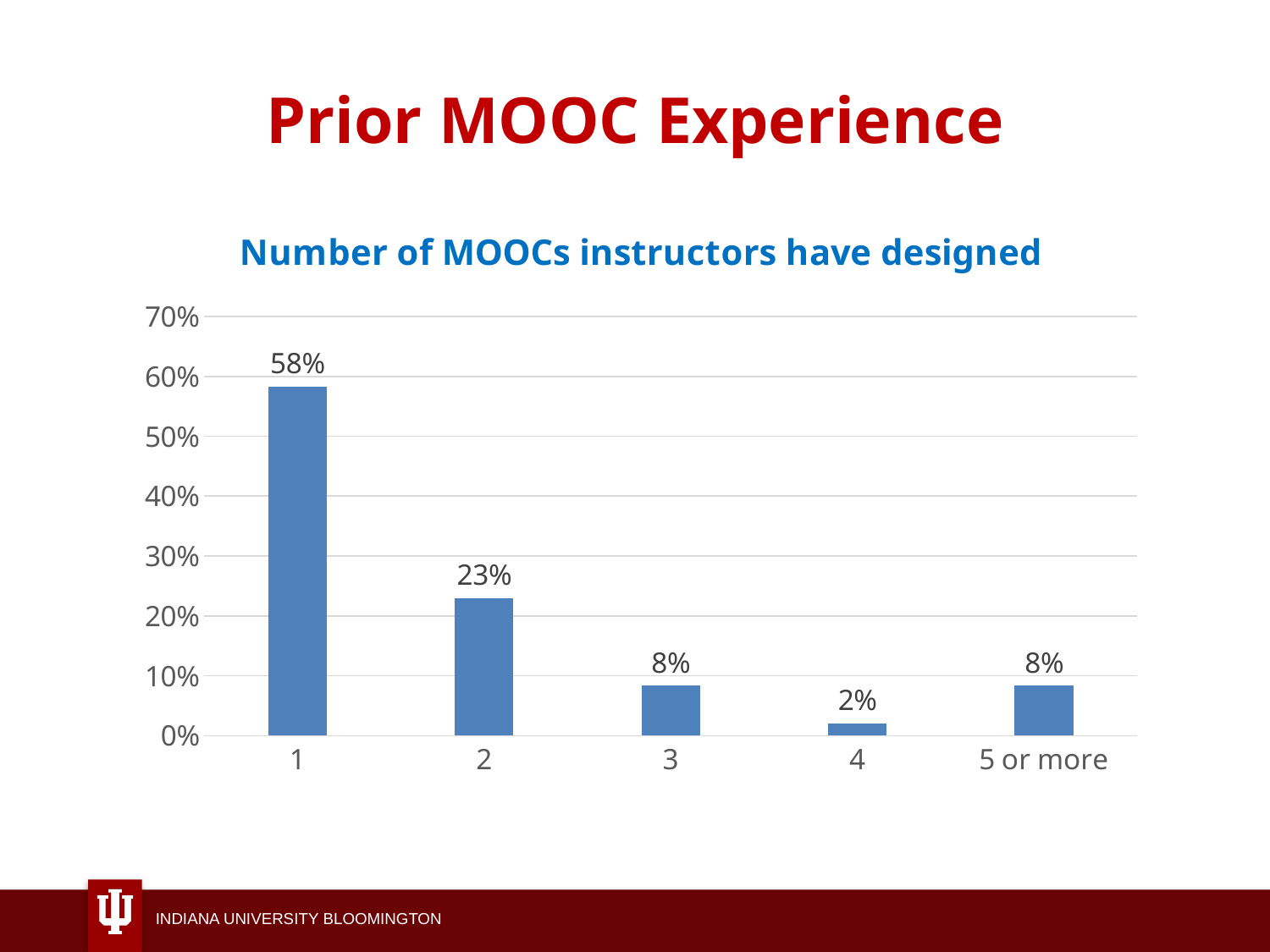
What is the difference between the percentages for 1 MOOC and 2 MOOCs? 35% Which category has the lowest percentage? 4 What kind of chart is shown on the slide? Bar chart Is the value for 1 MOOC greater or less than 50%? greater Which category has the highest percentage? 1 What percentage of instructors have designed 5 or more MOOCs? 8% Which is larger, the percentage for 2 MOOCs or for 3 MOOCs? 2 How many categories are shown on the x axis? 5 What is the title of the chart? Number of MOOCs instructors have designed What percentage of instructors have designed 1 MOOC? 58% What percentage of instructors have designed 4 MOOCs? 2% What percentage of instructors have designed 2 MOOCs? 23%